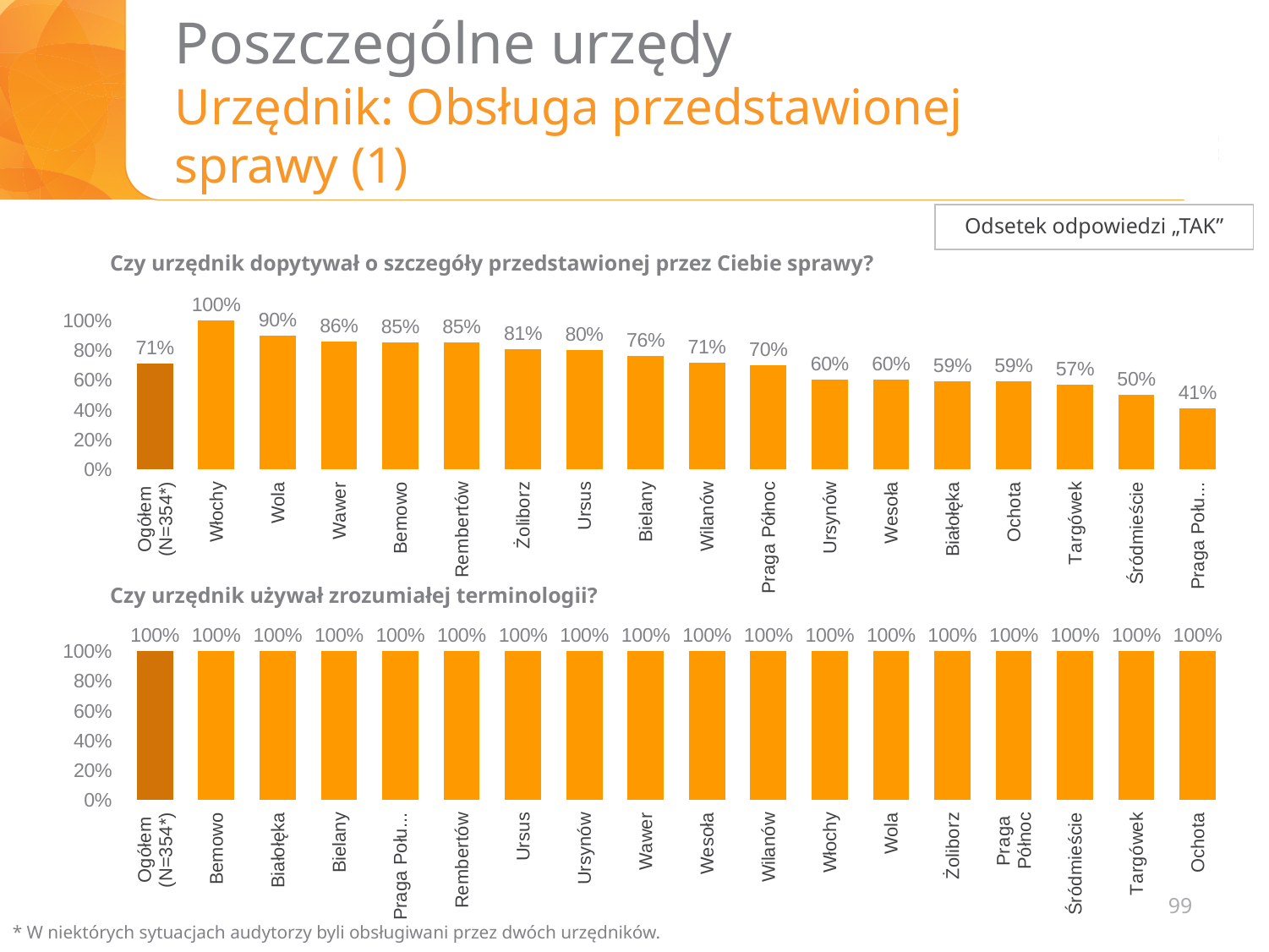
In the bottom chart (Czy urzędnik używał zrozumiałej terminologii?), what is the value for Bemowo? 100% In the bottom chart, do the values change across the districts along the x axis? No, all are 100% In the top chart, which district has the highest value? Włochy In the top chart, what is the value for Ogółem (N=354*)? 71% What type of chart is the bottom chart? Bar chart In the top chart (Czy urzędnik dopytywał o szczegóły przedstawionej przez Ciebie sprawy?), what is the value for Wola? 90% In the top chart, what is the difference between the values for Włochy and Śródmieście? 50 percentage points In the top chart, what is the value for Targówek? 57% In the top chart, what is the lowest value shown? 41% In the top chart, is the value for Ursynów greater or less than 80%? less In the top chart, how many bars are plotted? 18 In the top chart, which is larger, the value for Wawer or the value for Bielany? Wawer